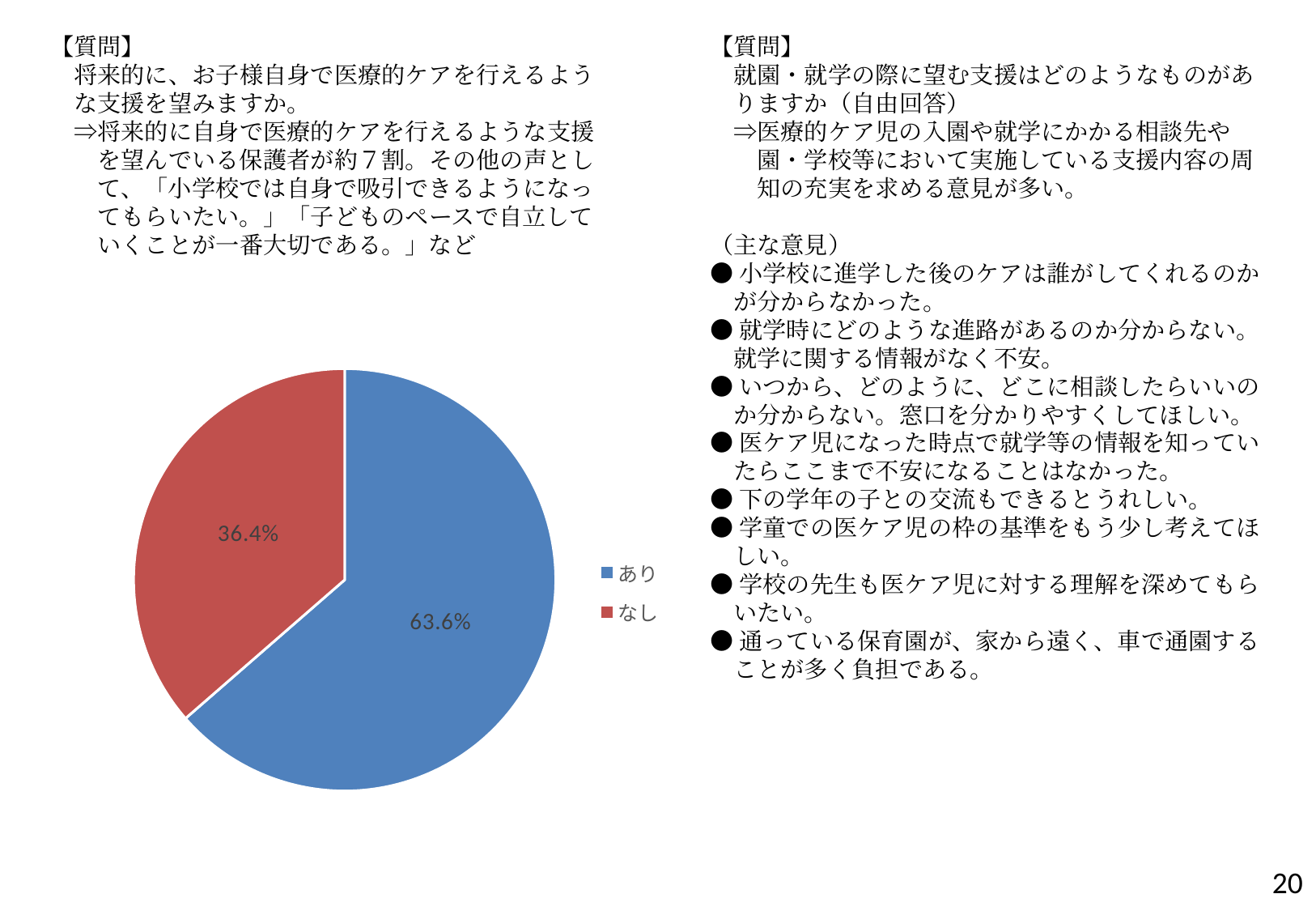
What colour is the slice for なし? red What is the difference in percentage points between あり and なし? 27.2 Is the share for あり greater or less than 50%? greater Which category has the largest share of the pie chart? あり What percentage is shown for あり in the pie chart? 63.6% What colour is the slice for あり? blue Which category has the smallest share of the pie chart? なし How many slices does the pie chart have? 2 What kind of chart is shown on the slide? pie chart How many entries does the legend list? 2 Which is larger, the share for あり or the share for なし? あり What percentage is shown for なし in the pie chart? 36.4%